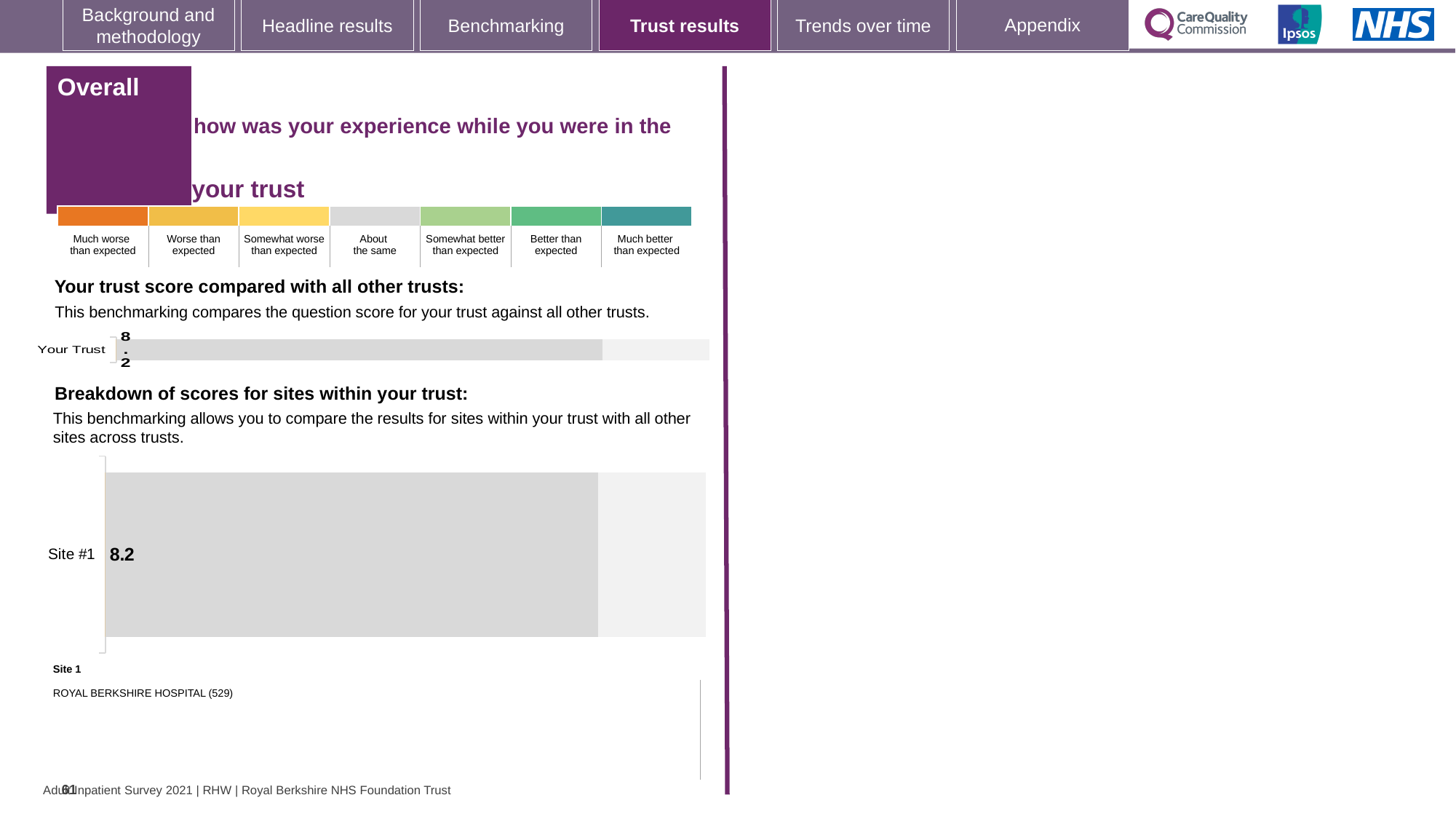
What kind of chart is the 'Breakdown of scores for sites within your trust' chart? Bar chart In the 'Your trust score compared with all other trusts' chart, what is the score for Your Trust? 8.2 What is the difference between the Your Trust score in the top chart and the Site #1 score in the bottom chart? 0.0 How many sites are shown in the 'Breakdown of scores for sites within your trust' chart? 1 What kind of chart is the 'Your trust score compared with all other trusts' chart? Bar chart In the 'Breakdown of scores for sites within your trust' chart, what is the label of the only bar? Site #1 In the 'Your trust score compared with all other trusts' chart, what is the label of the only bar? Your Trust In the 'Breakdown of scores for sites within your trust' chart, what is the score for Site #1? 8.2 How many bars are plotted in the 'Your trust score compared with all other trusts' chart? 1